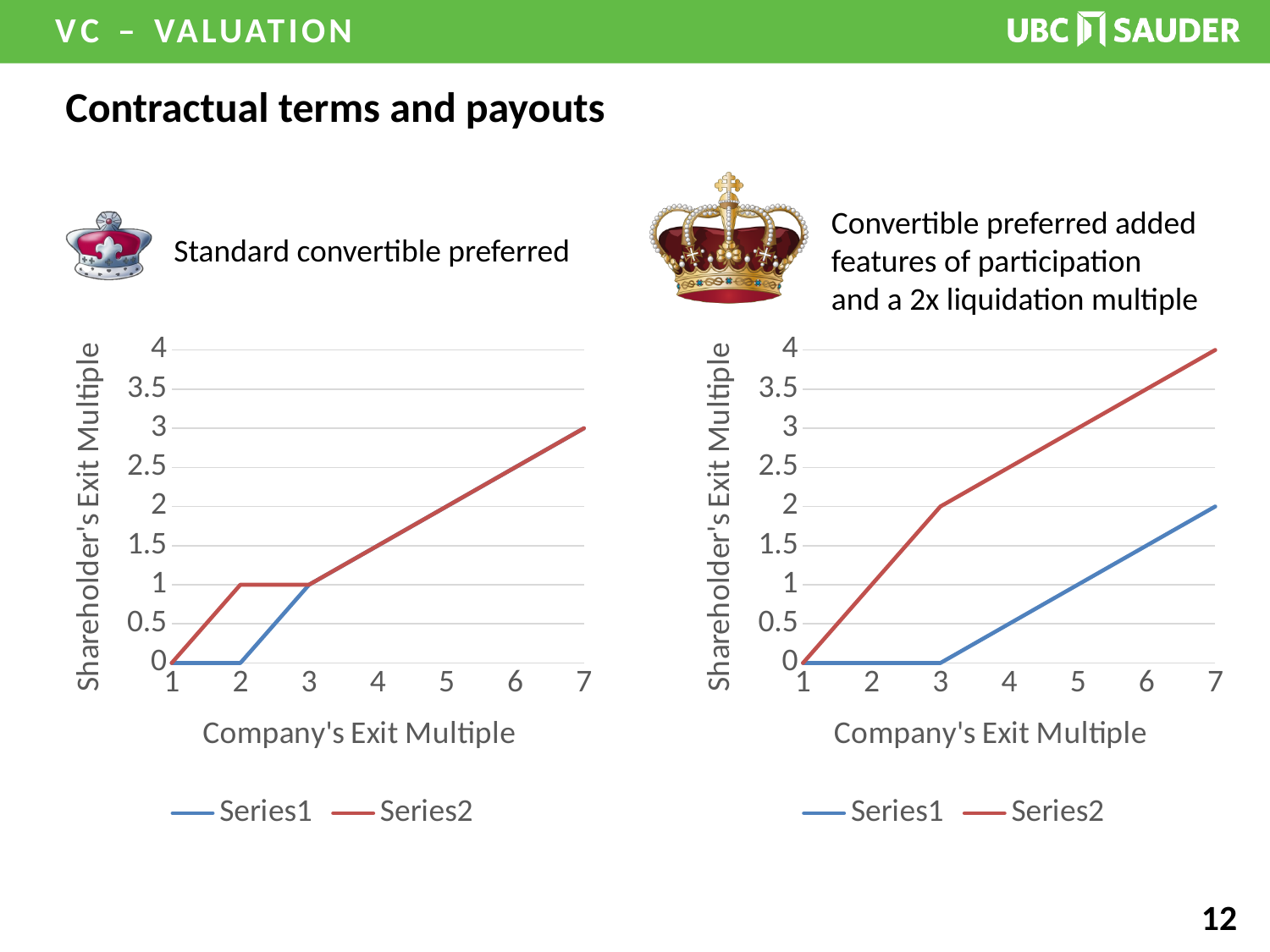
How many series does the legend of the right chart list? 2 In the left chart, is the value of Series2 at a Company's Exit Multiple of 5 greater or less than 1.5? greater In the left chart, what is the value of Series2 at a Company's Exit Multiple of 7? 3 In the right chart, does Series2 rise or fall as the Company's Exit Multiple increases from 1 to 7? rise In the right chart, which series is higher at a Company's Exit Multiple of 5, Series1 or Series2? Series2 In the left chart, what is the value of Series1 at a Company's Exit Multiple of 2? 0 In the right chart, what is the value of Series2 at a Company's Exit Multiple of 7? 4 In the right chart, what is the difference between Series2 and Series1 at a Company's Exit Multiple of 7? 2 In the right chart, what is the value of Series2 at a Company's Exit Multiple of 3? 2 What is the x-axis title of the left chart? Company's Exit Multiple What kind of chart is the left chart? line chart In the right chart, what is the value of Series1 at a Company's Exit Multiple of 7? 2